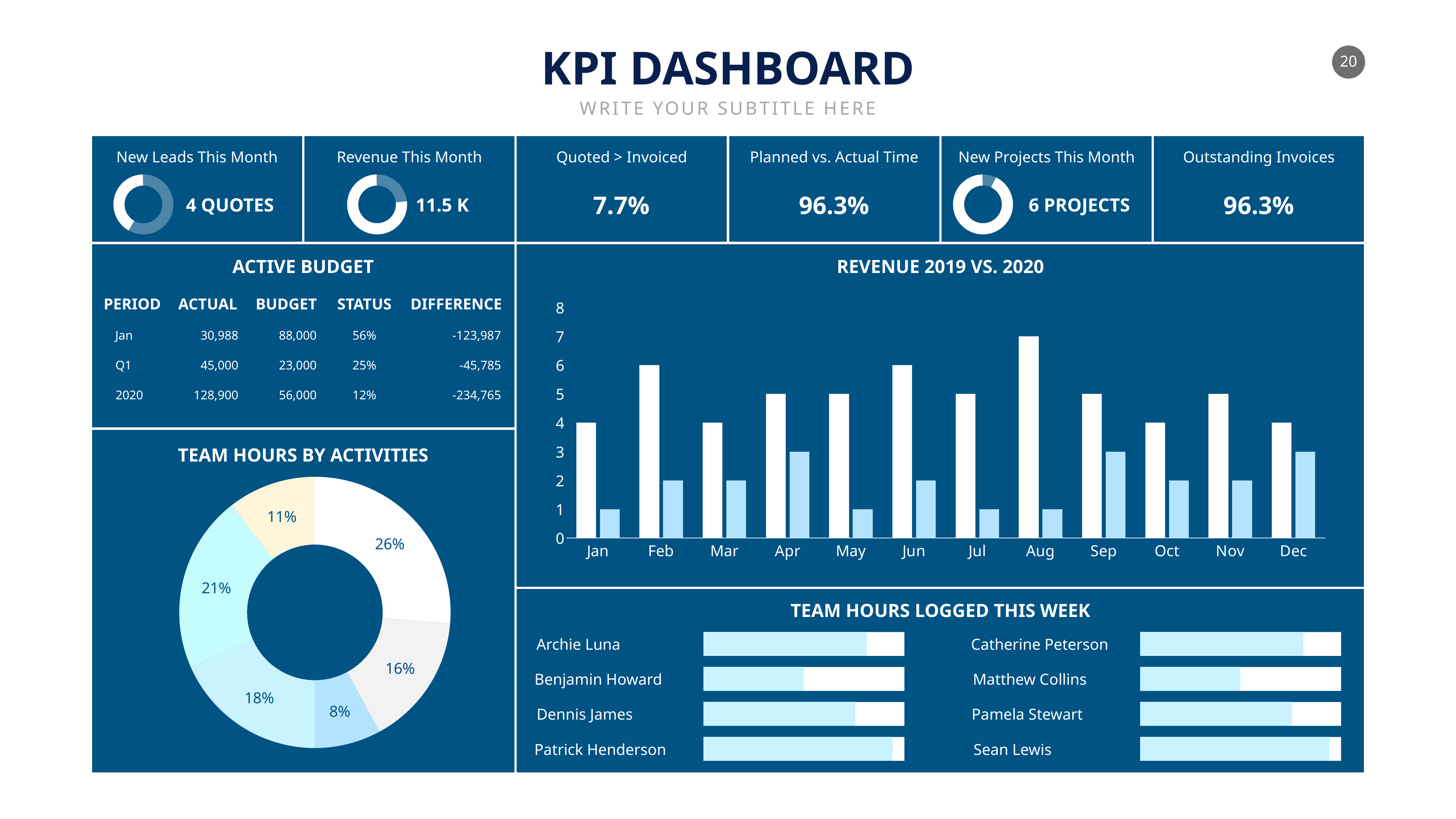
What kind of chart is 'Team Hours by Activities'? donut chart In the 'Revenue 2019 vs. 2020' chart, what is the value of the white bar for Aug? 7 In the 'Revenue 2019 vs. 2020' chart, what is the value of the light blue bar for Apr? 3 What is the largest percentage shown on the 'Team Hours by Activities' chart? 26% How many months are shown on the x axis of the 'Revenue 2019 vs. 2020' chart? 12 In the 'Revenue 2019 vs. 2020' chart, what is the difference between the white bar and the light blue bar for Feb? 4 What kind of chart is the 'Revenue 2019 vs. 2020' chart? bar chart What is the smallest percentage shown on the 'Team Hours by Activities' chart? 8% In the 'Revenue 2019 vs. 2020' chart, is the white bar for Jun greater or less than 5? greater How many slices does the 'Team Hours by Activities' chart have? 6 In the 'Revenue 2019 vs. 2020' chart, which month has the highest white bar? Aug In the 'Revenue 2019 vs. 2020' chart, which is larger: the white bar for Feb or the white bar for Mar? Feb